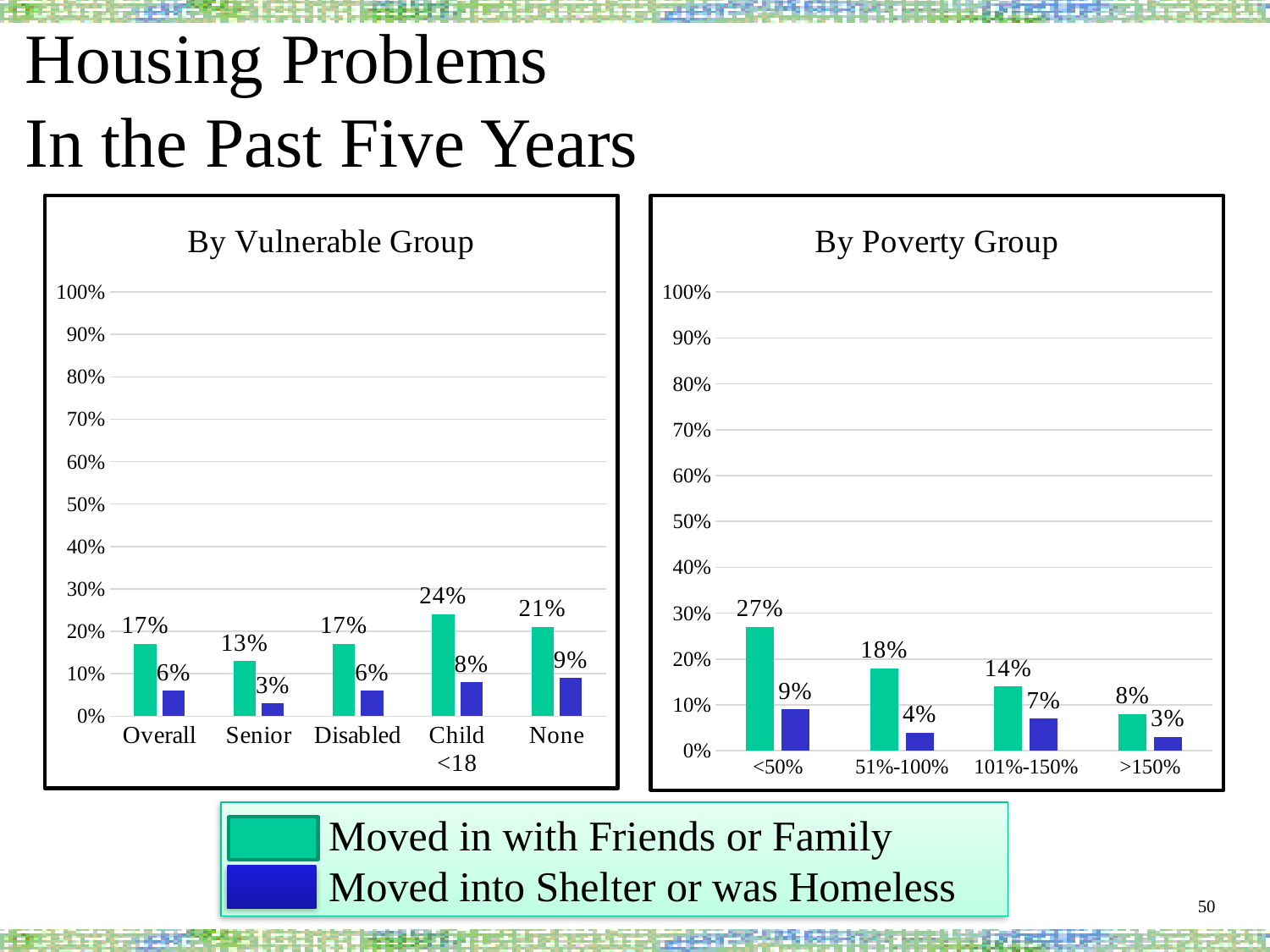
In the 'By Poverty Group' chart, what is the difference between the <50% group and the >150% group for moved in with friends or family? 19% In the 'By Vulnerable Group' chart, how many groups are shown on the x axis? 5 In the 'By Poverty Group' chart, how many poverty groups are shown on the x axis? 4 In the 'By Poverty Group' chart, do the values for moved in with friends or family rise or fall from <50% to >150%? Fall In the 'By Vulnerable Group' chart, which group has the highest percentage that moved in with friends or family? Child <18 In the 'By Poverty Group' chart, which group has the lowest percentage that moved into shelter or was homeless? >150% In the 'By Vulnerable Group' chart, what percentage of the Child <18 group moved in with friends or family? 24% What kind of chart is the 'By Poverty Group' chart? Bar chart In the 'By Vulnerable Group' chart, what is the value for Senior for moved into shelter or was homeless? 3% In the 'By Vulnerable Group' chart, which is larger for moved into shelter or was homeless: Senior or None? None In the 'By Poverty Group' chart, what percentage of the <50% group moved into shelter or was homeless? 9% How many series does the legend list? 2